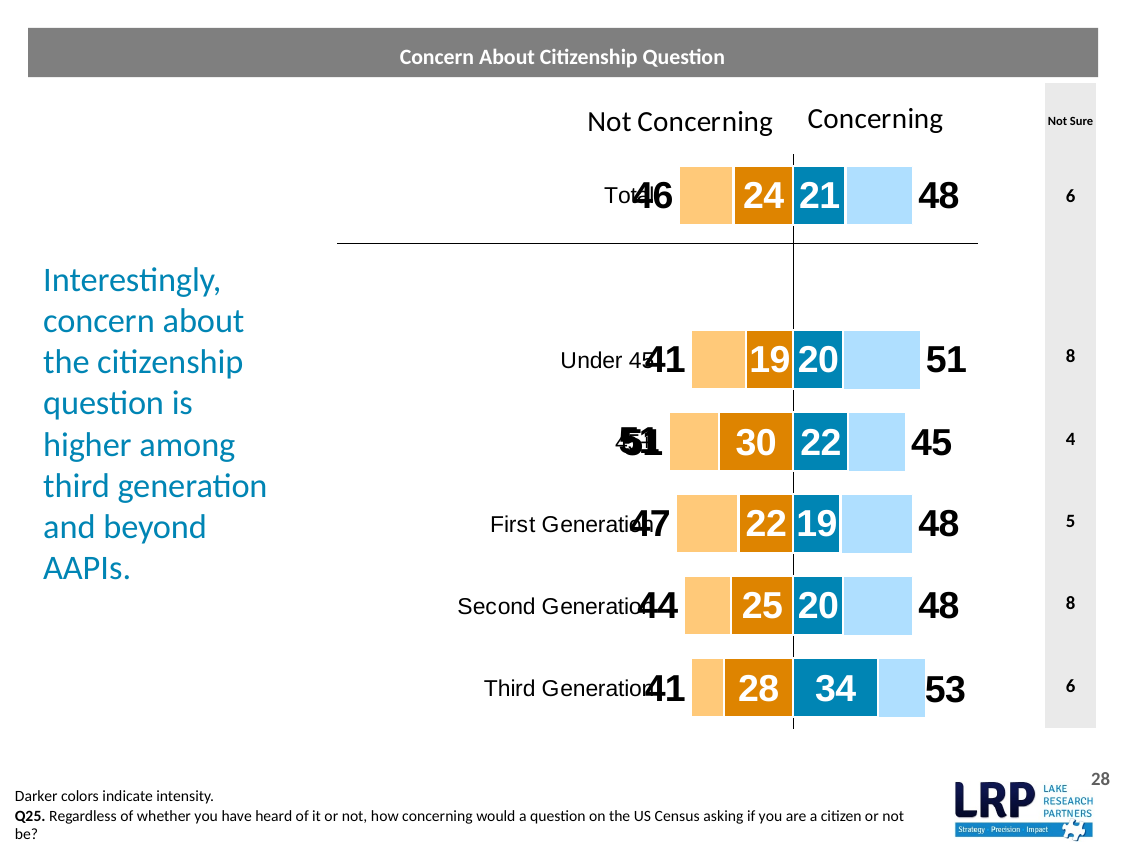
What is the total 'Not Concerning' value for Total? 46 What kind of chart is shown on the slide? Bar chart Which category has the lowest 'Not Sure' value? 45+ Which is larger, the 'Concerning' total for Under 45 or for Second Generation? Under 45 Which category has the highest total 'Concerning' value? Third Generation What is the difference between the 'Concerning' totals for Third Generation and First Generation? 5 What is the title of the chart? Concern About Citizenship Question What is the 'Not Sure' value for Under 45? 8 What is the dark blue (very concerning) value for Third Generation? 34 What is the total 'Concerning' value for Third Generation? 53 What is the dark orange (very not concerning) value for Second Generation? 25 How many categories (rows) are plotted in the chart? 6